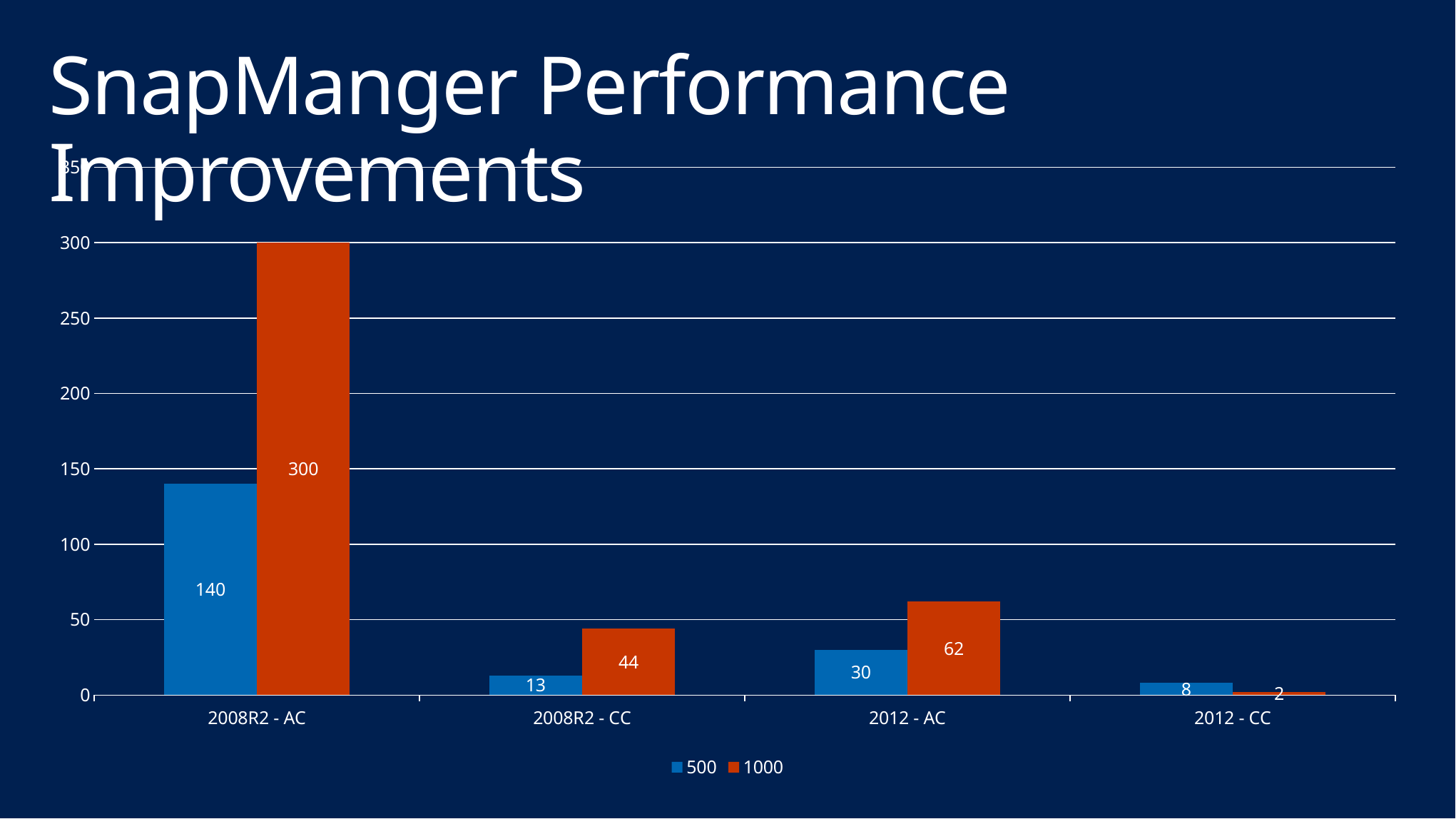
How many series does the legend list? 2 What is the value of the 500 series for 2012 - AC? 30 What is the value of the 1000 series for 2008R2 - CC? 44 Is the 500 value for 2008R2 - AC greater or less than 100? greater What is the value of the 1000 series for 2008R2 - AC? 300 How many categories are shown on the x axis? 4 Which category has the highest value in the 1000 series? 2008R2 - AC What is the difference between the 1000 and 500 values for 2008R2 - AC? 160 Which category has the lowest value in the 500 series? 2012 - CC What is the value of the 500 series for 2012 - CC? 8 What kind of chart is shown on the slide? bar chart Which is larger for 2012 - AC: the 500 value or the 1000 value? 1000